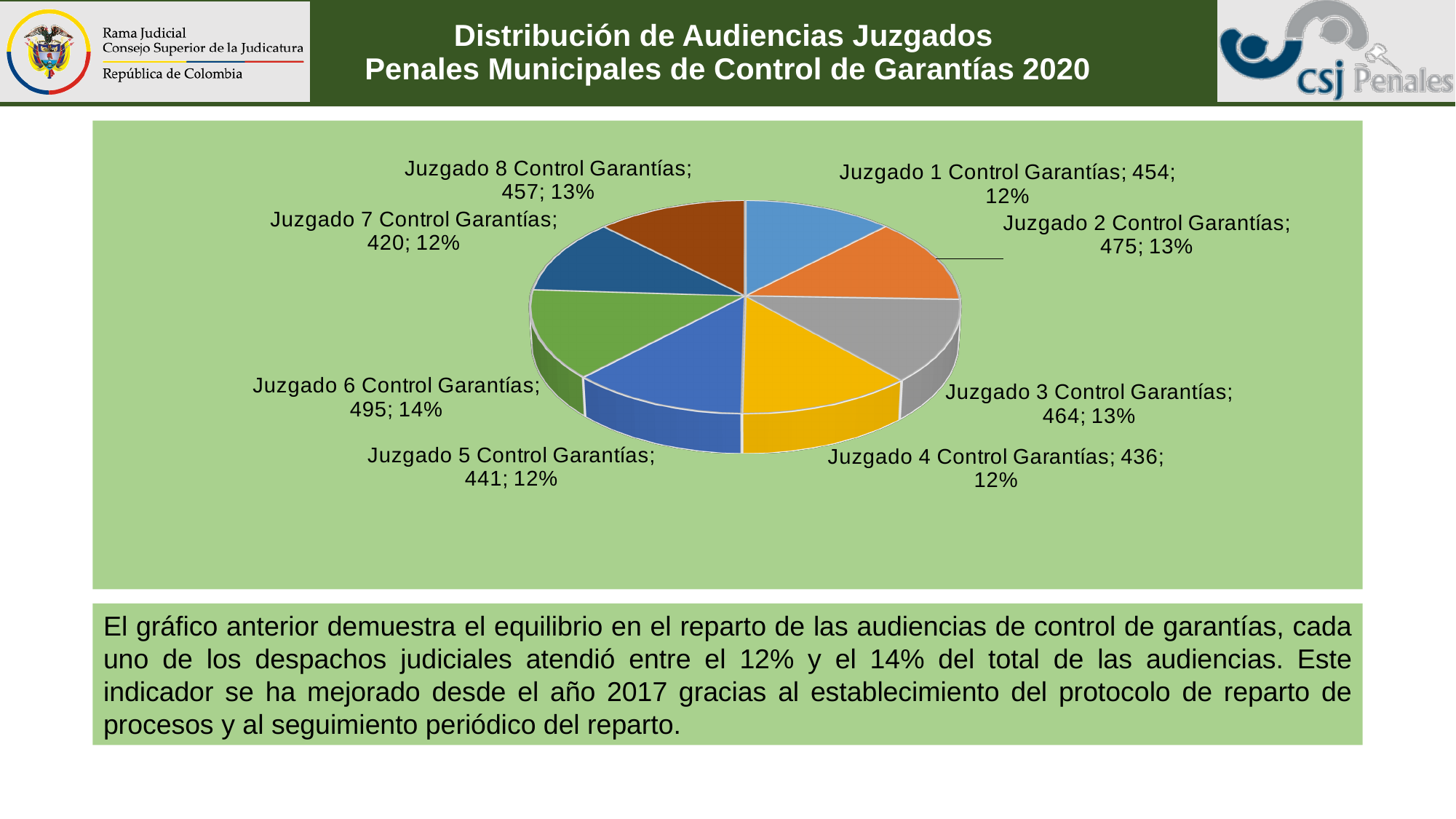
What percentage share does Juzgado 6 Control Garantías have? 14% Which juzgado has the lowest number of audiencias? Juzgado 7 Control Garantías What is the value for Juzgado 2 Control Garantías? 475 What is the difference between the values for Juzgado 8 Control Garantías and Juzgado 1 Control Garantías? 3 What is the difference between the values for Juzgado 6 Control Garantías and Juzgado 7 Control Garantías? 75 What kind of chart is shown on the slide? Pie chart What is the title of the chart on the slide? Distribución de Audiencias Juzgados Penales Municipales de Control de Garantías 2020 How many slices does the pie chart have? 8 What is the value for Juzgado 6 Control Garantías? 495 What percentage share does Juzgado 7 Control Garantías have? 12% Which juzgado has the highest number of audiencias? Juzgado 6 Control Garantías Which has a larger value, Juzgado 3 Control Garantías or Juzgado 4 Control Garantías? Juzgado 3 Control Garantías